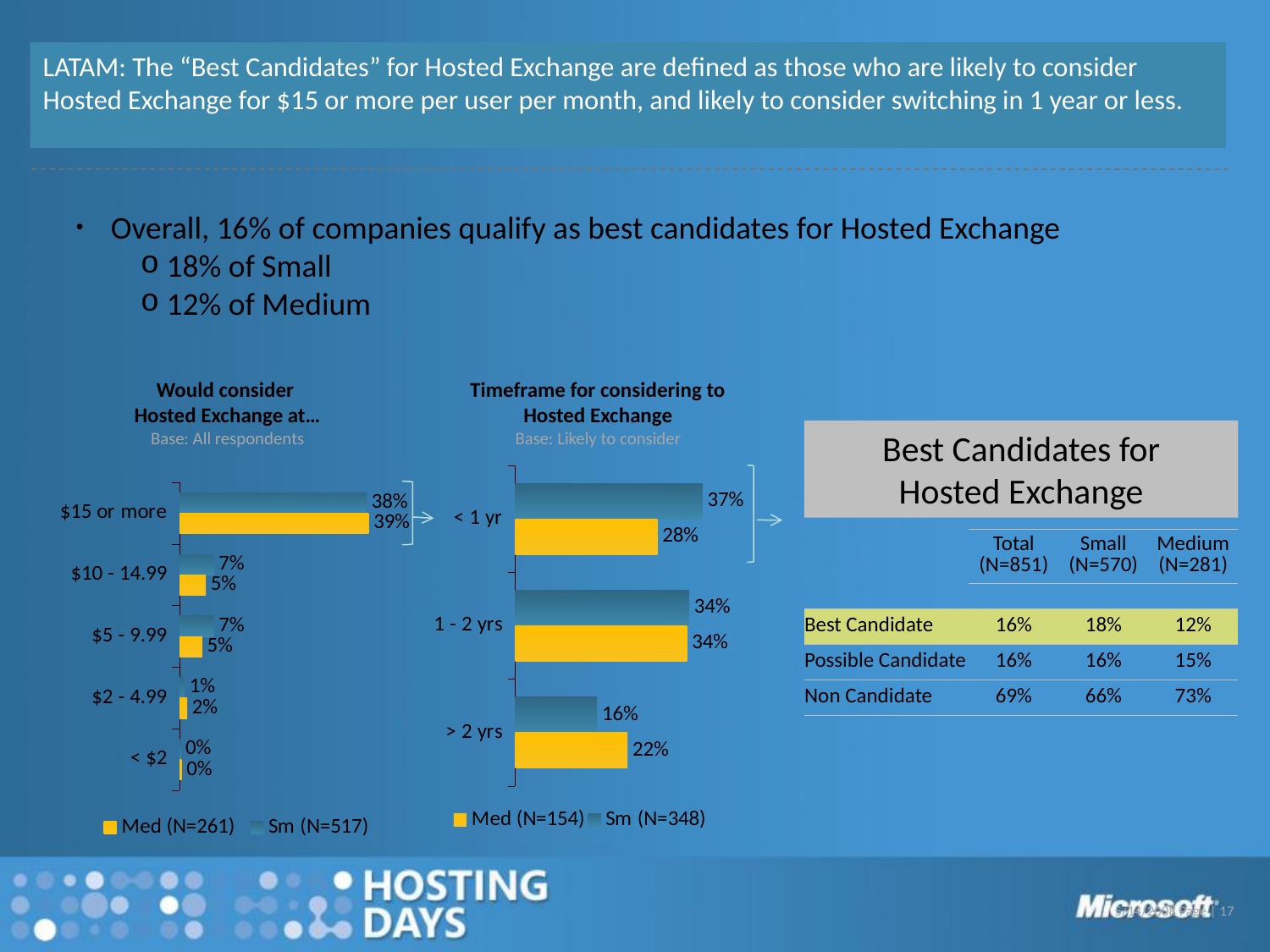
In the 'Timeframe for considering to Hosted Exchange' chart, what is the value for Med (N=154) at '> 2 yrs'? 22% What type of chart is the 'Would consider Hosted Exchange at...' chart? Bar chart How many series does the legend of the 'Timeframe for considering to Hosted Exchange' chart list? 2 In the 'Would consider Hosted Exchange at...' chart, which category has the highest value for Sm (N=517)? $15 or more In the 'Would consider Hosted Exchange at...' chart, what is the value for Sm (N=517) at '$10 - 14.99'? 7% In the 'Would consider Hosted Exchange at...' chart, what is the value for Med (N=261) at '$15 or more'? 39% In the 'Timeframe for considering to Hosted Exchange' chart, which is larger at '< 1 yr': Med (N=154) or Sm (N=348)? Sm (N=348) In the 'Timeframe for considering to Hosted Exchange' chart, what is the value for Sm (N=348) at '< 1 yr'? 37% In the 'Would consider Hosted Exchange at...' chart, what is the difference between the Med (N=261) and Sm (N=517) values at '$2 - 4.99'? 1% In the 'Would consider Hosted Exchange at...' chart, how many price categories are shown? 5 In the 'Timeframe for considering to Hosted Exchange' chart, what is the difference between Sm (N=348) and Med (N=154) at '< 1 yr'? 9% In the 'Timeframe for considering to Hosted Exchange' chart, which category has the lowest value for Sm (N=348)? > 2 yrs